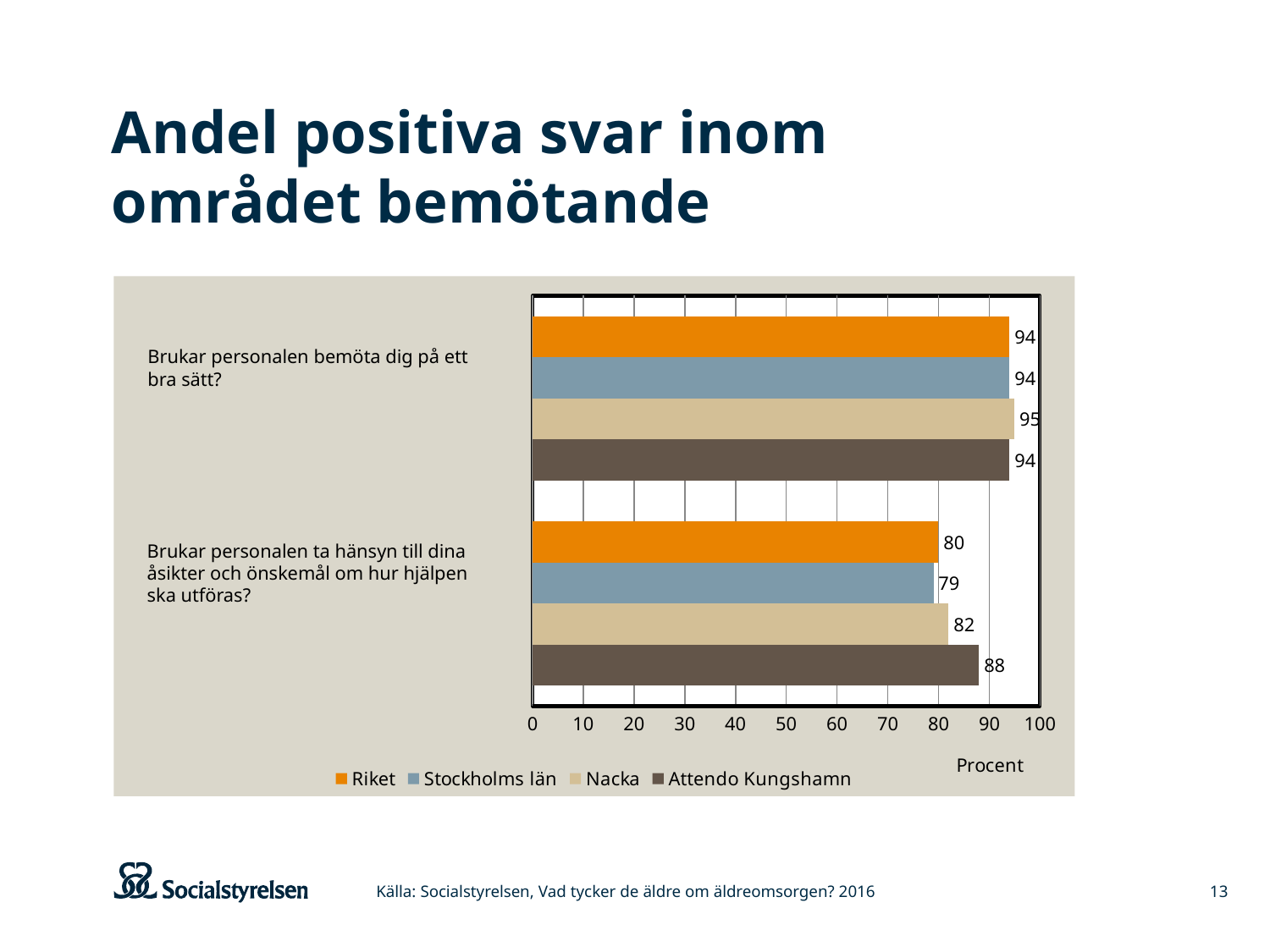
What is the value for Stockholms län on "Brukar personalen ta hänsyn till dina åsikter och önskemål om hur hjälpen ska utföras?"? 79 What is the label on the horizontal axis of the chart? Procent What is the value for Attendo Kungshamn on "Brukar personalen ta hänsyn till dina åsikter och önskemål om hur hjälpen ska utföras?"? 88 Which is larger for Nacka: the value on "Brukar personalen bemöta dig på ett bra sätt?" or on "Brukar personalen ta hänsyn till dina åsikter och önskemål om hur hjälpen ska utföras?"? Brukar personalen bemöta dig på ett bra sätt? How many question categories are shown on the chart? 2 What is the value for Riket on "Brukar personalen bemöta dig på ett bra sätt?"? 94 What is the difference between Attendo Kungshamn and Riket on "Brukar personalen ta hänsyn till dina åsikter och önskemål om hur hjälpen ska utföras?"? 8 What is the value for Nacka on "Brukar personalen bemöta dig på ett bra sätt?"? 95 Which series has the highest value on "Brukar personalen ta hänsyn till dina åsikter och önskemål om hur hjälpen ska utföras?"? Attendo Kungshamn What kind of chart is shown on the slide? Bar chart Which series has the lowest value on "Brukar personalen ta hänsyn till dina åsikter och önskemål om hur hjälpen ska utföras?"? Stockholms län How many series does the legend list? 4